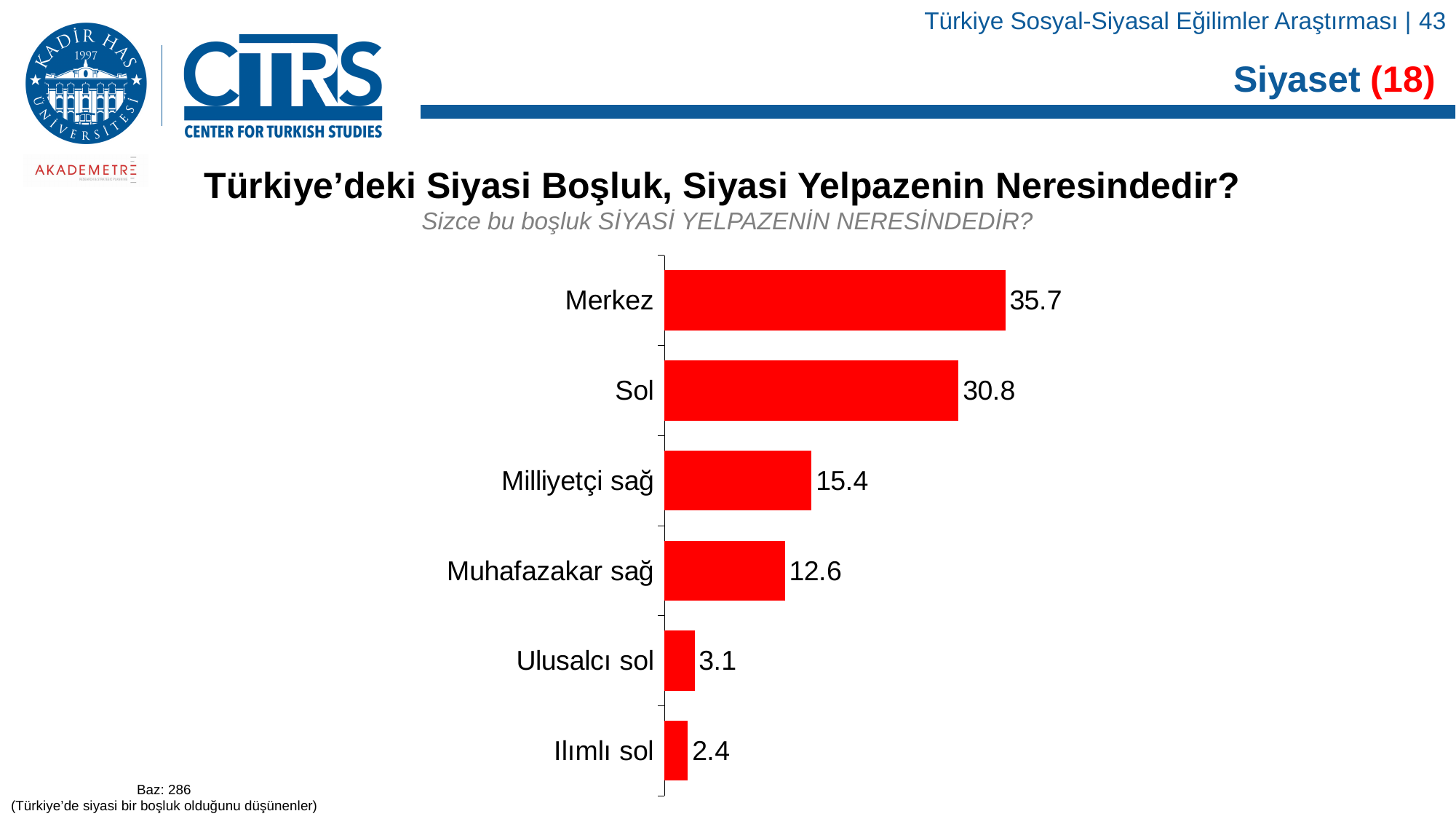
What is the value for Merkez? 35.7 What is the difference between the values for Milliyetçi sağ and Muhafazakar sağ? 2.8 What is the value for Milliyetçi sağ? 15.4 What is the difference between the values for Merkez and Sol? 4.9 What is the value for Ilımlı sol? 2.4 Which is larger, the value for Sol or the value for Muhafazakar sağ? Sol Which category has the highest value? Merkez How many categories are shown in the chart? 6 Which is larger, the value for Ulusalcı sol or the value for Ilımlı sol? Ulusalcı sol Which category has the lowest value? Ilımlı sol What kind of chart is shown on the slide? bar chart What is the base (Baz) number of respondents shown below the chart? 286